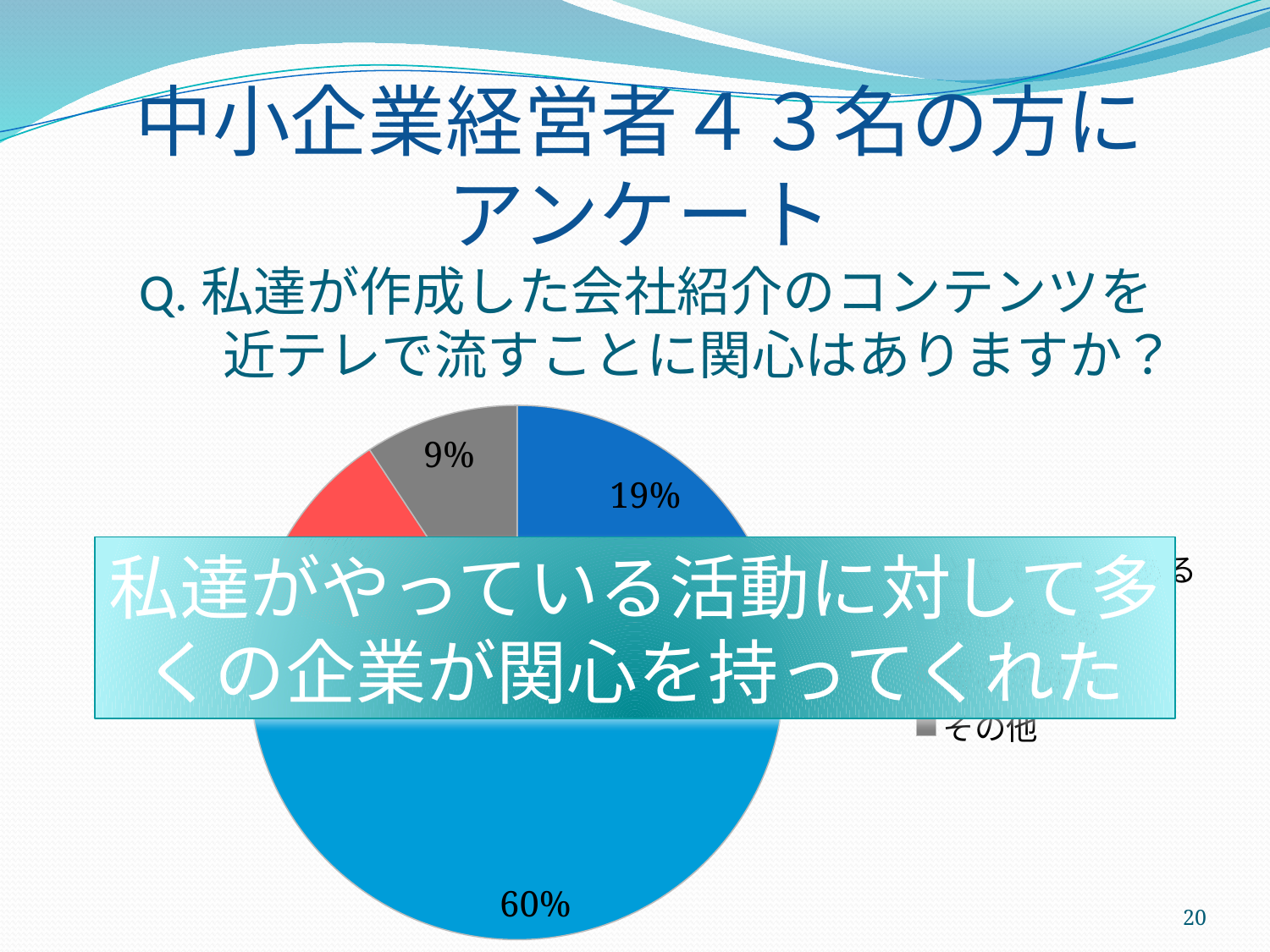
What percentage is shown on the dark blue slice of the pie chart? 19% Which legend entry is shown with a grey marker? その他 Which is larger, the dark blue slice or the grey slice? the dark blue slice What is the difference in percentage points between the dark blue slice (19%) and the grey slice (9%)? 10 How many slices does the pie chart have? 4 What percentage is shown for the largest slice of the pie chart? 60% What share of the pie does the grey slice labelled その他 represent? 9% Is the share of the light blue slice greater or less than 50%? greater Which colour is the largest slice of the pie chart? light blue What kind of chart is shown on the slide? pie chart